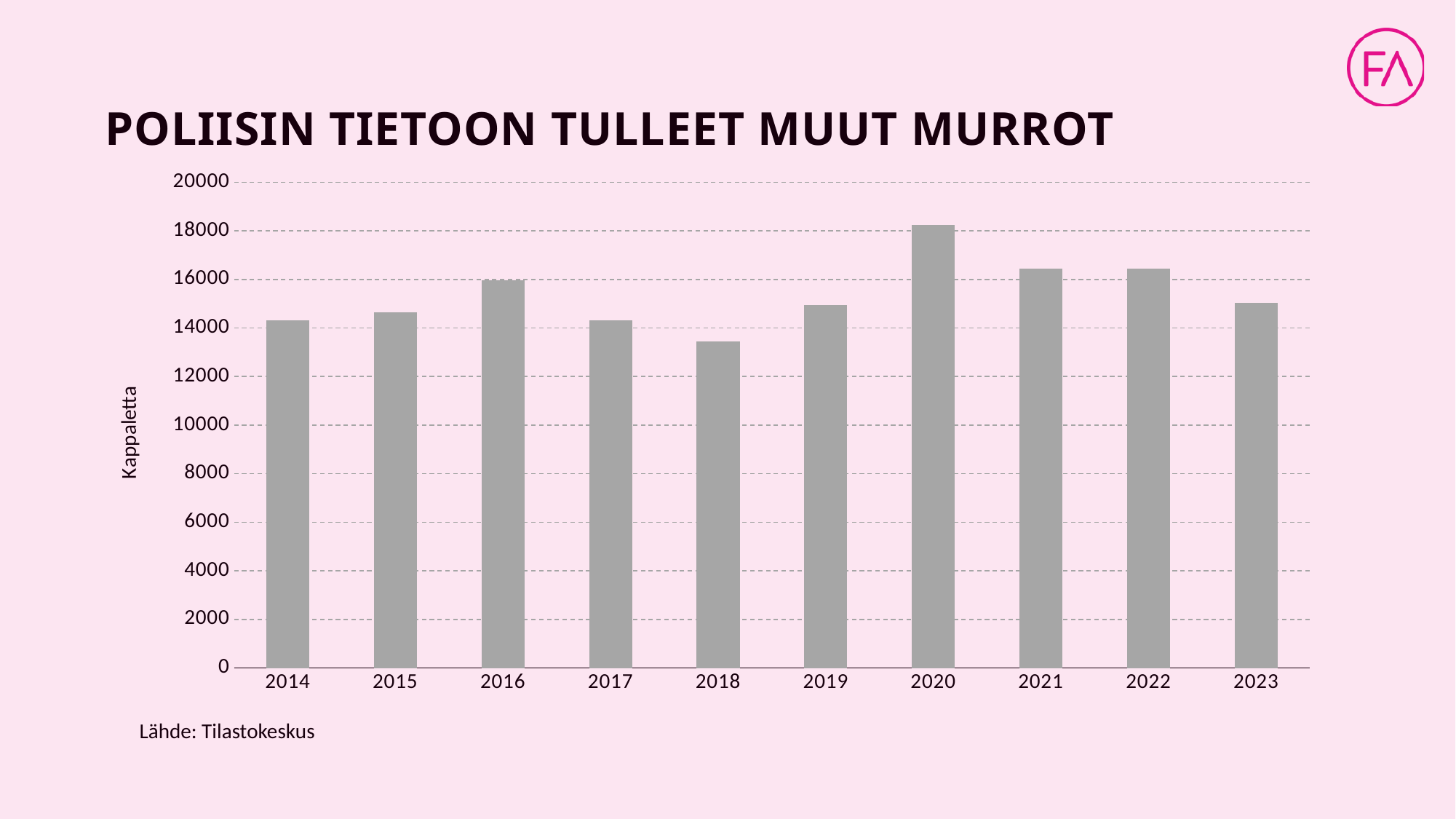
Is the value for 2018 greater or less than 14000? less Is the value for 2020 greater or less than 16000? greater How many years are shown on the x axis of the chart? 10 Is the value for 2021 greater or less than 16000? greater Which year has the larger value, 2016 or 2017? 2016 Do the values rise or fall from 2018 to 2020? rise What kind of chart is shown on the slide? bar chart Which year has the lowest number of reported break-ins in the chart? 2018 What is the label on the y axis of the chart? Kappaletta Which year has the highest number of reported break-ins in the chart? 2020 What is the title of the chart? POLIISIN TIETOON TULLEET MUUT MURROT